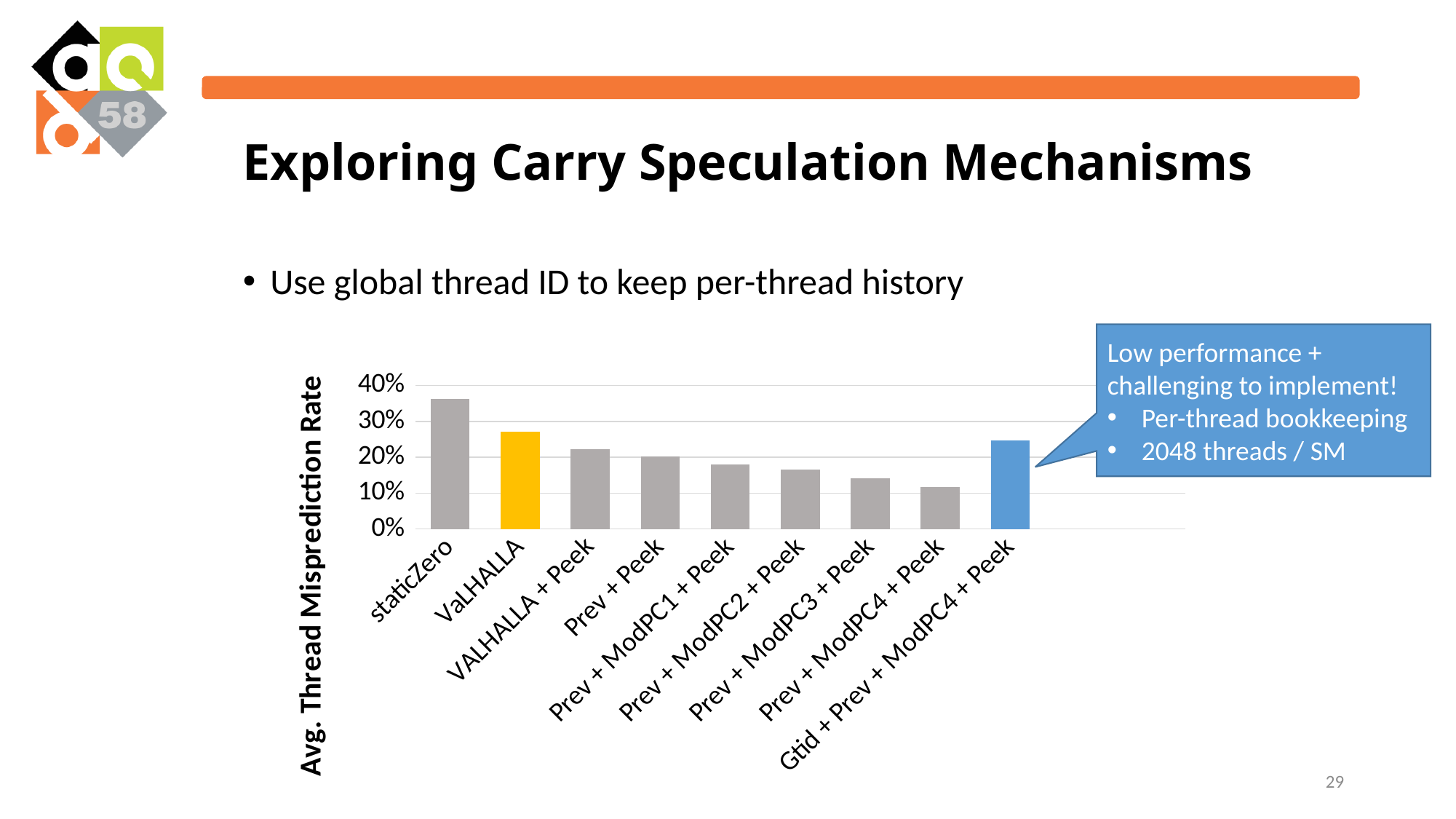
What kind of chart is shown on the slide? bar chart Is the value for Prev + ModPC4 + Peek greater or less than 20%? less How many categories (bars) are plotted in the chart? 9 Which category's bar is coloured yellow/orange in the chart? VALHALLA Which category has the lowest average thread misprediction rate? Prev + ModPC4 + Peek Which has a higher misprediction rate, VALHALLA or VALHALLA + Peek? VALHALLA Is the value for Prev + ModPC3 + Peek greater or less than 10%? greater Which category has the highest average thread misprediction rate? staticZero Is the value for Gtid + Prev + ModPC4 + Peek greater or less than 20%? greater What is the label of the vertical axis of the chart? Avg. Thread Misprediction Rate Which has a higher misprediction rate, Gtid + Prev + ModPC4 + Peek or Prev + ModPC4 + Peek? Gtid + Prev + ModPC4 + Peek